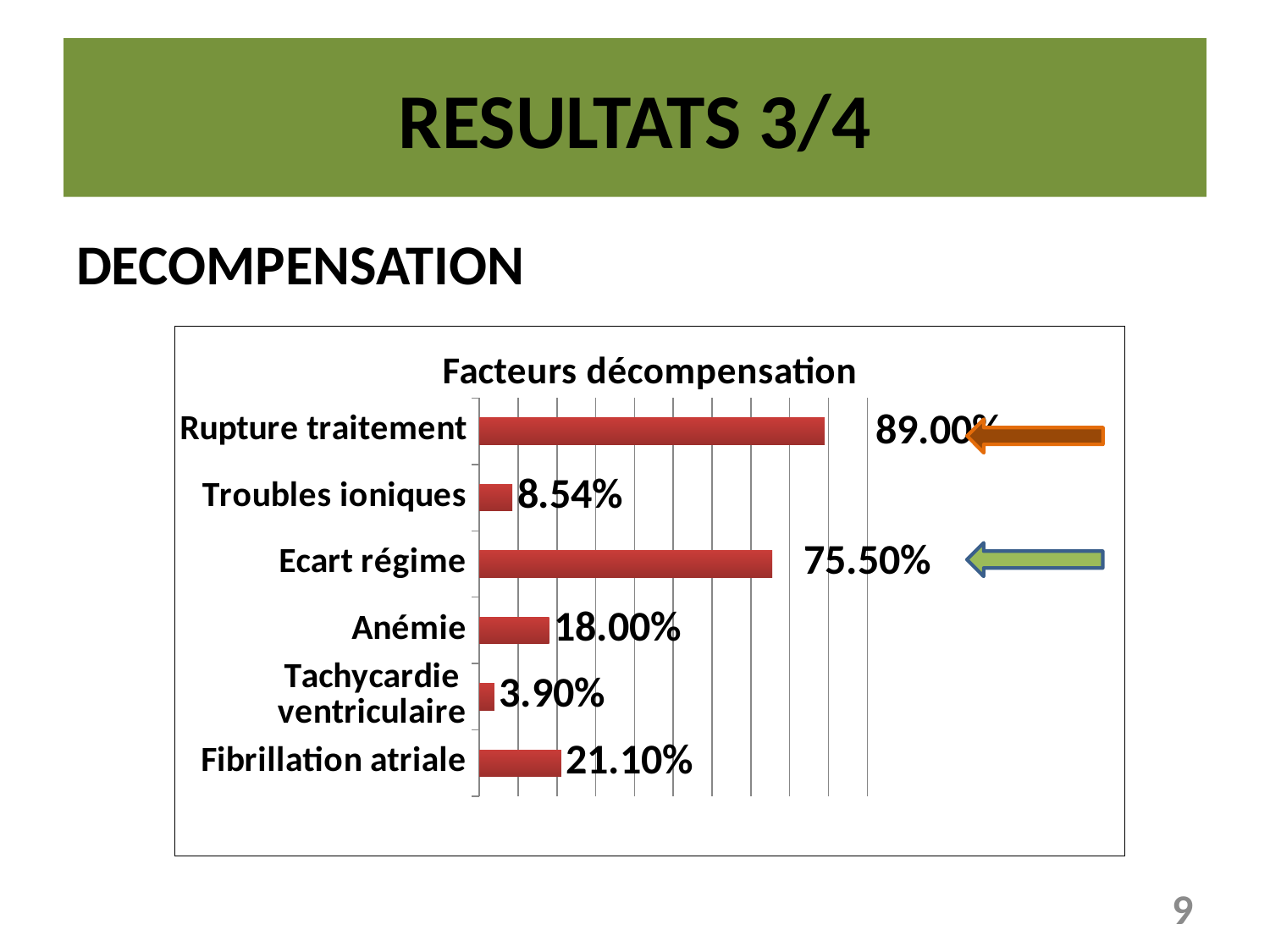
How many categories are shown in the chart? 6 Which is larger, the value for Fibrillation atriale or the value for Anémie? Fibrillation atriale What is the value for Fibrillation atriale? 21.10% What is the value for Anémie? 18.00% What is the value for Ecart régime? 75.50% Which category has the highest value? Rupture traitement What is the difference between the values for Rupture traitement and Ecart régime? 13.50% What is the title of the chart? Facteurs décompensation What is the value for Tachycardie ventriculaire? 3.90% What is the value for Rupture traitement? 89.00% Which category has the lowest value? Tachycardie ventriculaire What is the value for Troubles ioniques? 8.54%